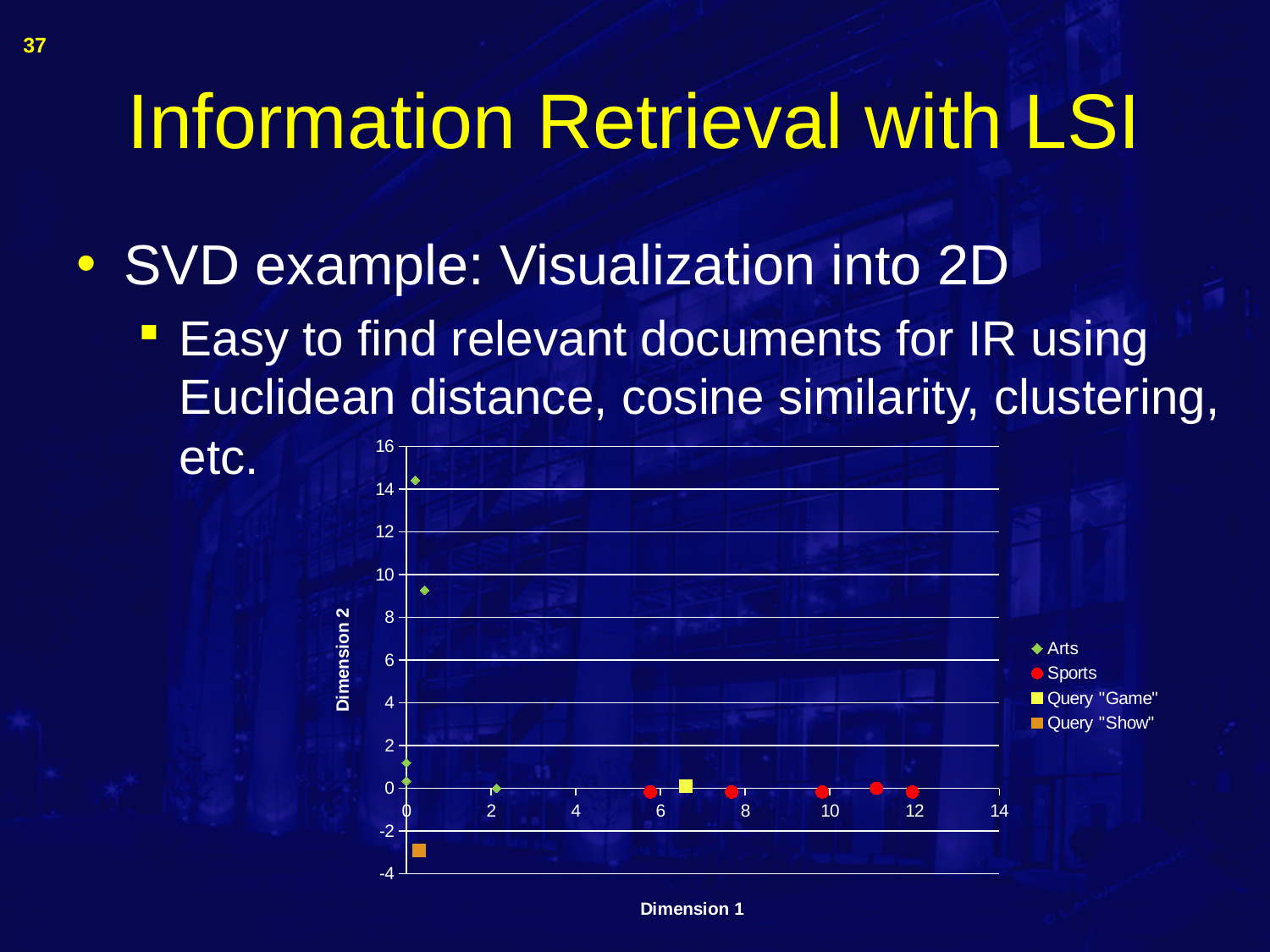
Which series contains the point with the highest Dimension 2 value? Arts Which has the larger Dimension 2 value, the Query "Game" point or the Query "Show" point? Query "Game" What is the title of the chart's horizontal axis? Dimension 1 Is the Dimension 2 value of the highest Arts point greater or less than 12? greater How many series does the chart's legend list? 4 What are the series names listed in the chart's legend? Arts, Sports, Query "Game", Query "Show" What kind of chart is shown on the slide? scatter chart How many Query "Game" points are plotted on the chart? 1 Is the Dimension 1 value of the Query "Game" point greater or less than 4? greater Is the Dimension 2 value of the Query "Show" point greater or less than 0? less Which series contains the point with the lowest Dimension 2 value? Query "Show" How many Sports points are plotted on the chart? 5